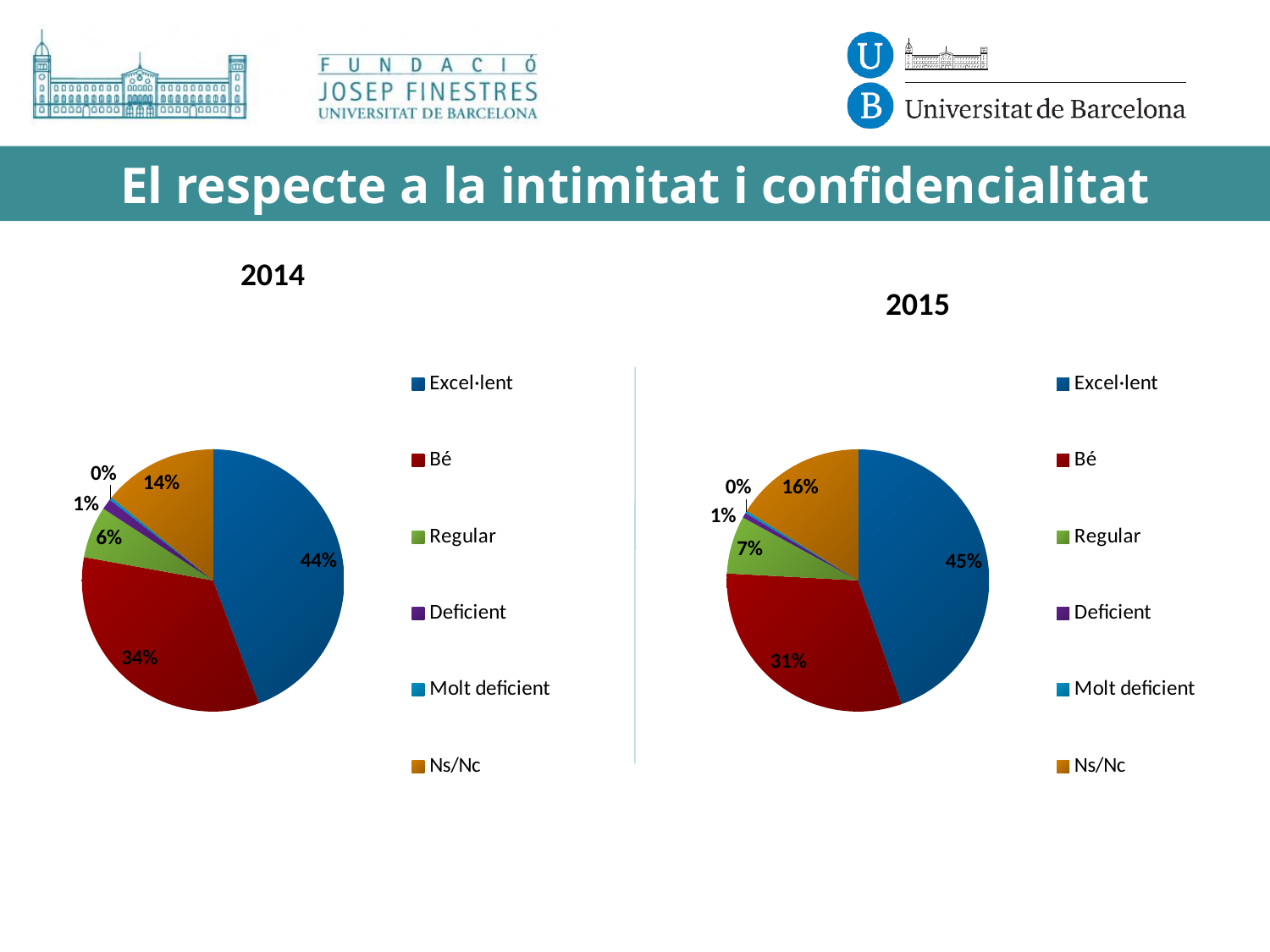
What is the title of the slide? El respecte a la intimitat i confidencialitat In the 2014 pie chart, what is the difference between the Excel·lent and Bé shares? 10% In the 2015 pie chart, which category has the largest slice? Excel·lent In the 2014 pie chart, what share does Excel·lent have? 44% In the 2015 pie chart, what is the difference between the Ns/Nc and Regular shares? 9% Which is larger: the Bé share in the 2014 chart or the Bé share in the 2015 chart? 2014 What type of chart is used for the 2014 data? Pie chart In the 2014 pie chart, which category has the smallest slice? Molt deficient How many categories does the legend of the 2015 pie chart list? 6 In the 2015 pie chart, what share does Bé have? 31% In the 2014 pie chart, what share does Ns/Nc have? 14% In the 2015 pie chart, what share does Regular have? 7%